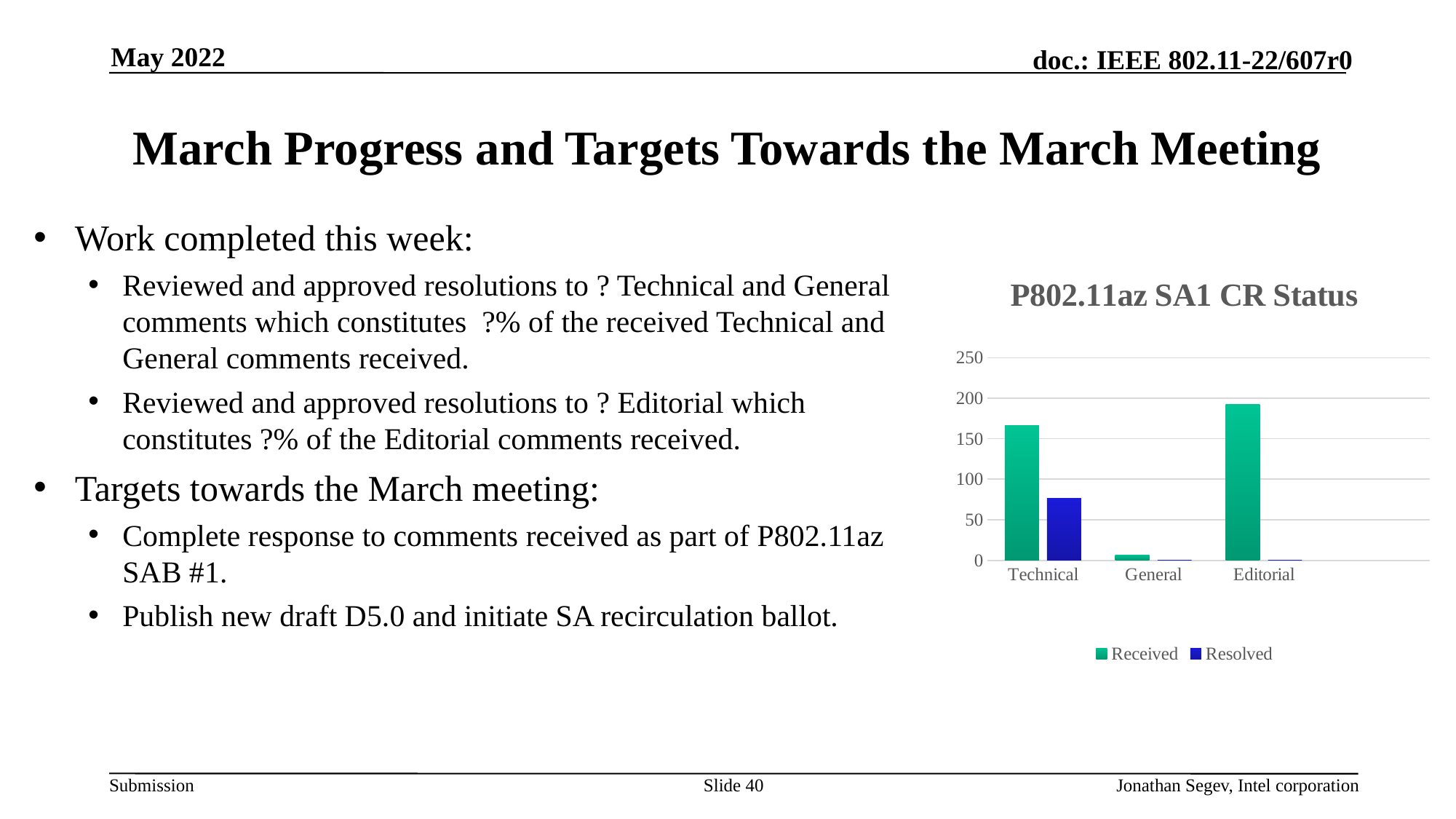
For Technical, which is larger: Received or Resolved? Received What kind of chart is shown on the slide? bar chart What are the two series named in the chart's legend? Received and Resolved How many categories are shown on the x axis of the chart? 3 Is the Received value for Technical greater or less than 150? greater Which category has the lowest Received value? General Is the Received value for General greater or less than 50? less What is the title of the chart? P802.11az SA1 CR Status Which category has the highest Resolved value? Technical How many series does the chart's legend list? 2 Which category has the highest Received value? Editorial Is the Resolved value for Technical greater or less than 100? less